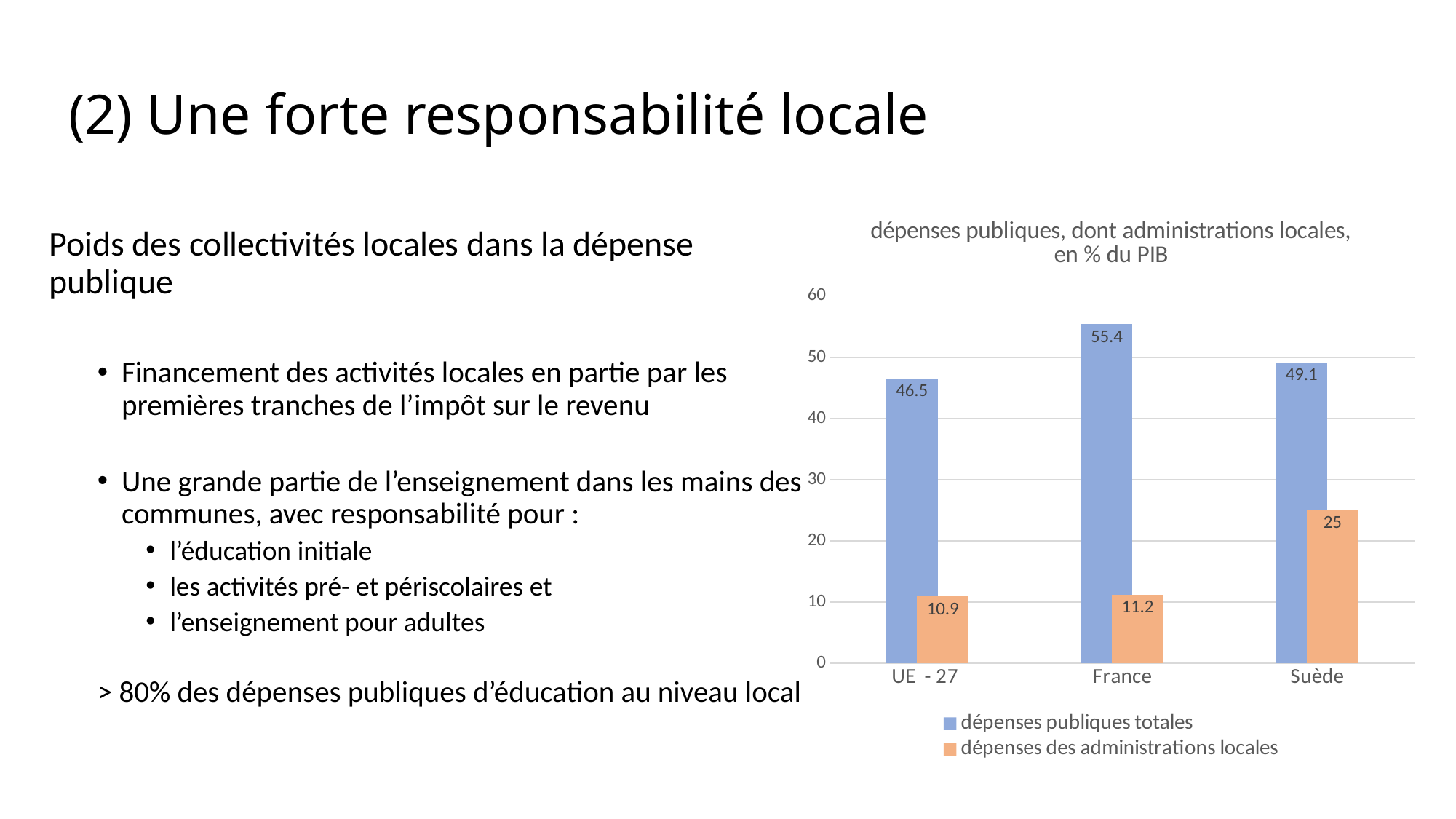
What kind of chart is shown on the slide? bar chart What is the value of dépenses des administrations locales for Suède? 25 Is the value of dépenses publiques totales for Suède greater or less than 40? greater What is the difference between dépenses publiques totales for France and for UE - 27? 8.9 Which category has the highest value for dépenses publiques totales? France How many categories are shown on the x axis? 3 What is the value of dépenses publiques totales for France? 55.4 How many series does the legend list? 2 What is the value of dépenses des administrations locales for UE - 27? 10.9 What is the title of the chart? dépenses publiques, dont administrations locales, en % du PIB Which is larger: dépenses des administrations locales for Suède or for France? Suède Which category has the lowest value for dépenses des administrations locales? UE - 27